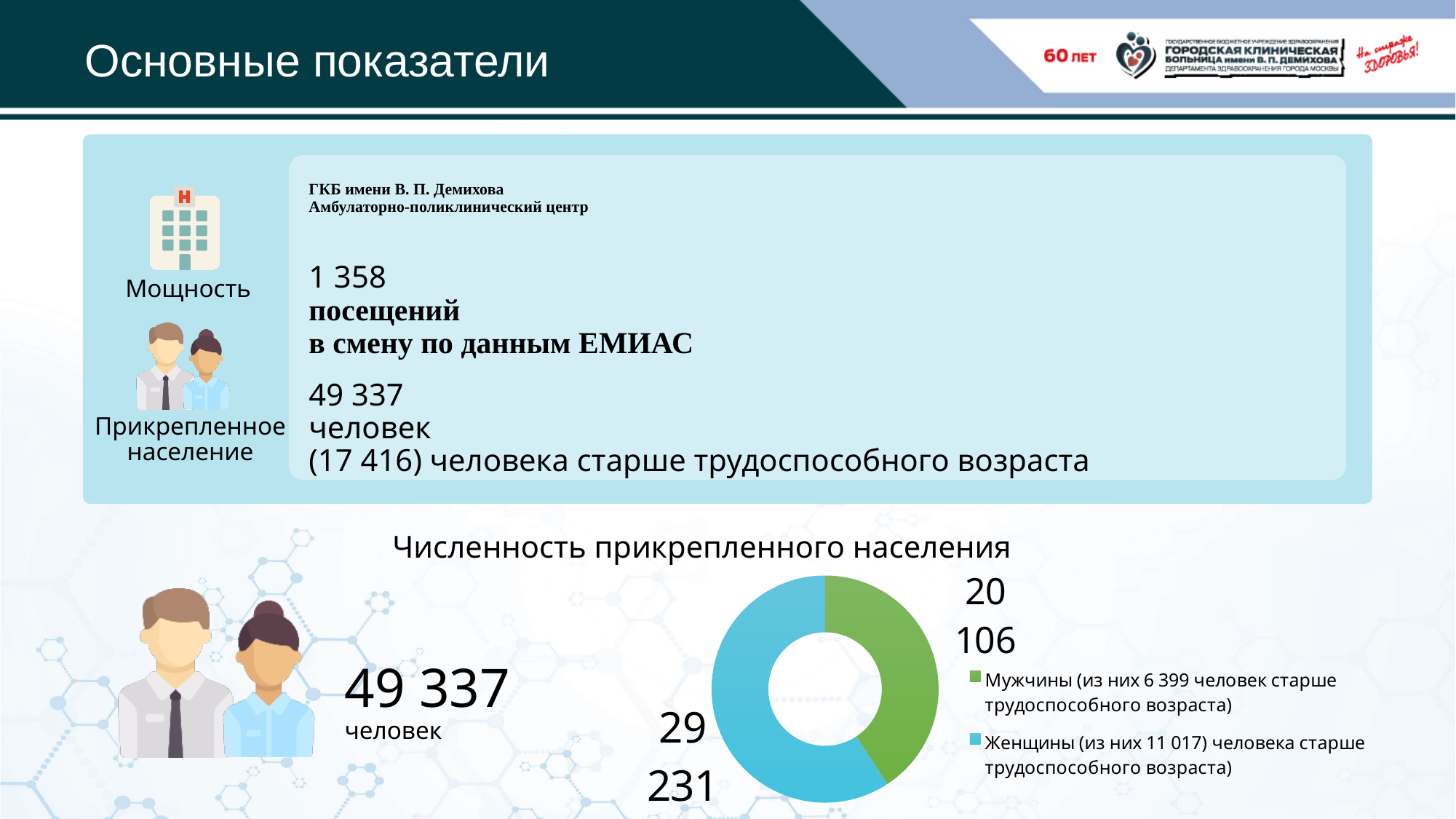
What value is shown for Мужчины in the doughnut chart? 20 106 What type of chart is shown under the title "Численность прикрепленного населения"? Doughnut (pie) chart What is the difference between the Женщины and Мужчины values in the doughnut chart? 9 125 What is the total of the two slices in the doughnut chart? 49 337 Which slice of the doughnut chart is the smallest? Мужчины How many entries does the legend of the doughnut chart list? 2 Which colour represents Женщины in the doughnut chart? Blue What is the title of the chart on the slide? Численность прикрепленного населения How many slices does the doughnut chart have? 2 Which slice of the doughnut chart is the largest? Женщины What value is shown for Женщины in the doughnut chart? 29 231 Which is larger in the doughnut chart: Мужчины or Женщины? Женщины